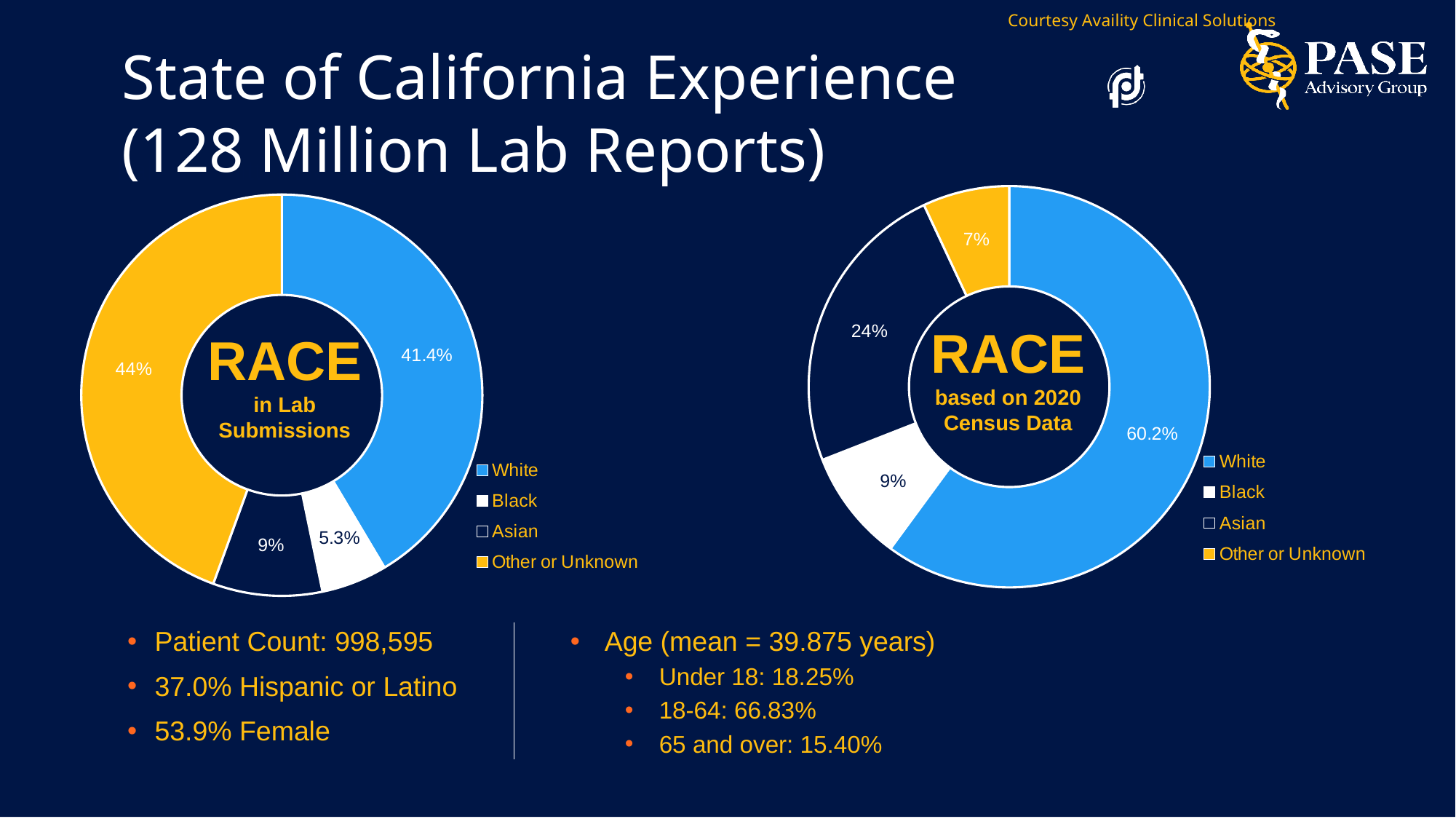
In the 'RACE based on 2020 Census Data' chart, what share is labelled for White? 60.2% In the 'RACE based on 2020 Census Data' chart, what share is labelled for Black? 9% In the 'RACE in Lab Submissions' chart, what share is labelled for White? 41.4% In the 'RACE based on 2020 Census Data' chart, which category has the smallest share? Other or Unknown In the 'RACE in Lab Submissions' chart, what share is labelled for Other or Unknown? 44% In the 'RACE in Lab Submissions' chart, what is the difference between the Other or Unknown share and the White share? 2.6% What kind of chart is the 'RACE based on 2020 Census Data' chart? Donut (pie) chart How many categories does the legend of the 'RACE in Lab Submissions' chart list? 4 In the 'RACE in Lab Submissions' chart, what share is labelled for Asian? 9% In the 'RACE based on 2020 Census Data' chart, is the share for Black larger or smaller than the share for Asian? smaller In the 'RACE in Lab Submissions' chart, which category has the smallest share? Black In the 'RACE based on 2020 Census Data' chart, which category has the largest share? White